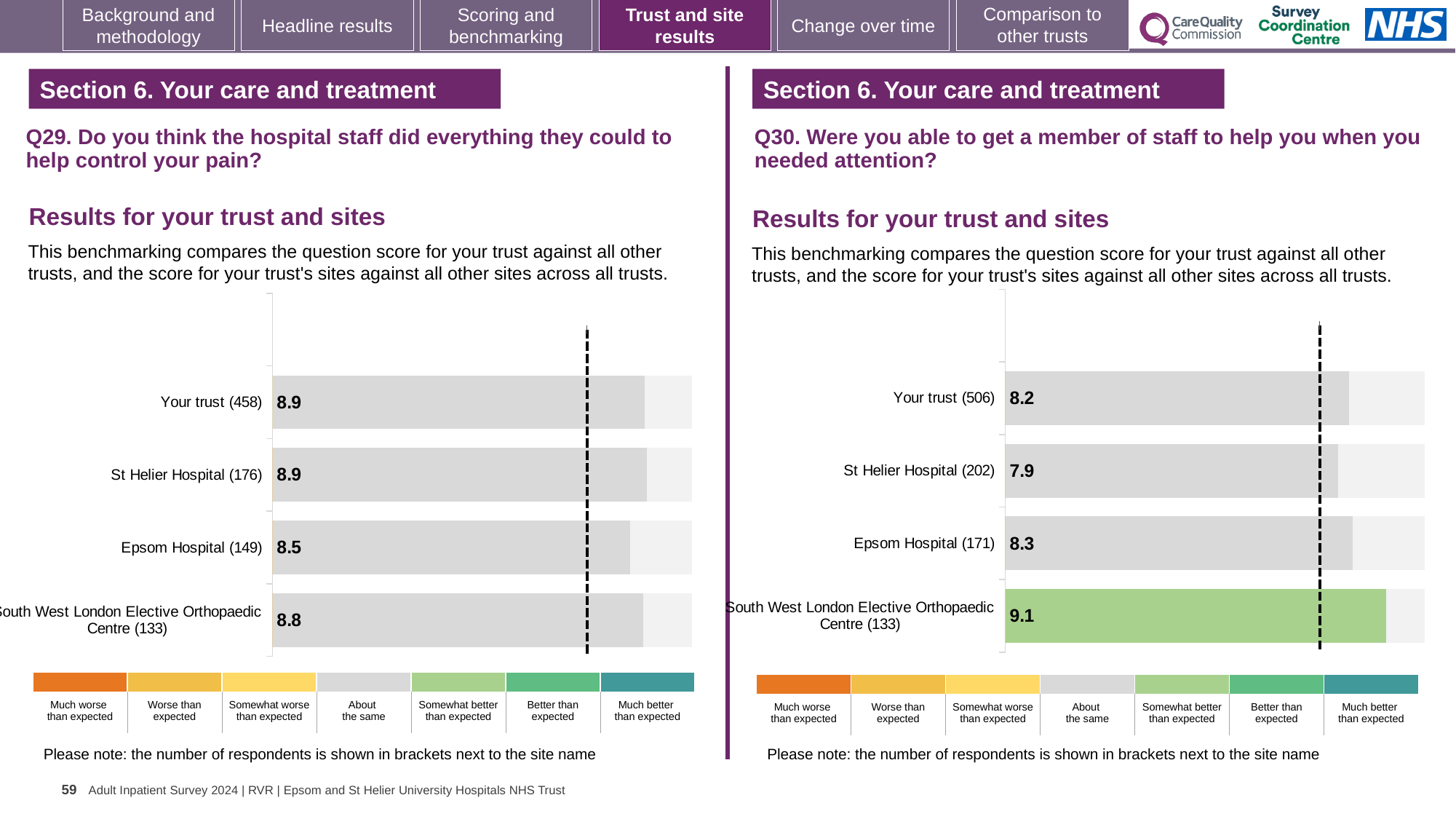
On the Q29 chart (left), what is the difference between the scores for Your trust and Epsom Hospital? 0.4 On the Q30 chart (right), what is the score for Your trust? 8.2 On the Q29 chart (left), which site has the lowest score? Epsom Hospital On the Q29 chart (left), what is the score for Epsom Hospital? 8.5 On the Q30 chart (right), what is the score for St Helier Hospital? 7.9 On the Q30 chart (right), what is the difference between the scores for South West London Elective Orthopaedic Centre and St Helier Hospital? 1.2 On the Q30 chart (right), which site has the highest score? South West London Elective Orthopaedic Centre On the Q30 chart (right), which site has the lowest score? St Helier Hospital How many bars are shown on the Q29 chart (left)? 4 On the Q29 chart (left), what is the score for South West London Elective Orthopaedic Centre? 8.8 What type of chart is used on the Q30 chart (right)? Bar chart On the Q30 chart (right), which has the higher score, Epsom Hospital or St Helier Hospital? Epsom Hospital